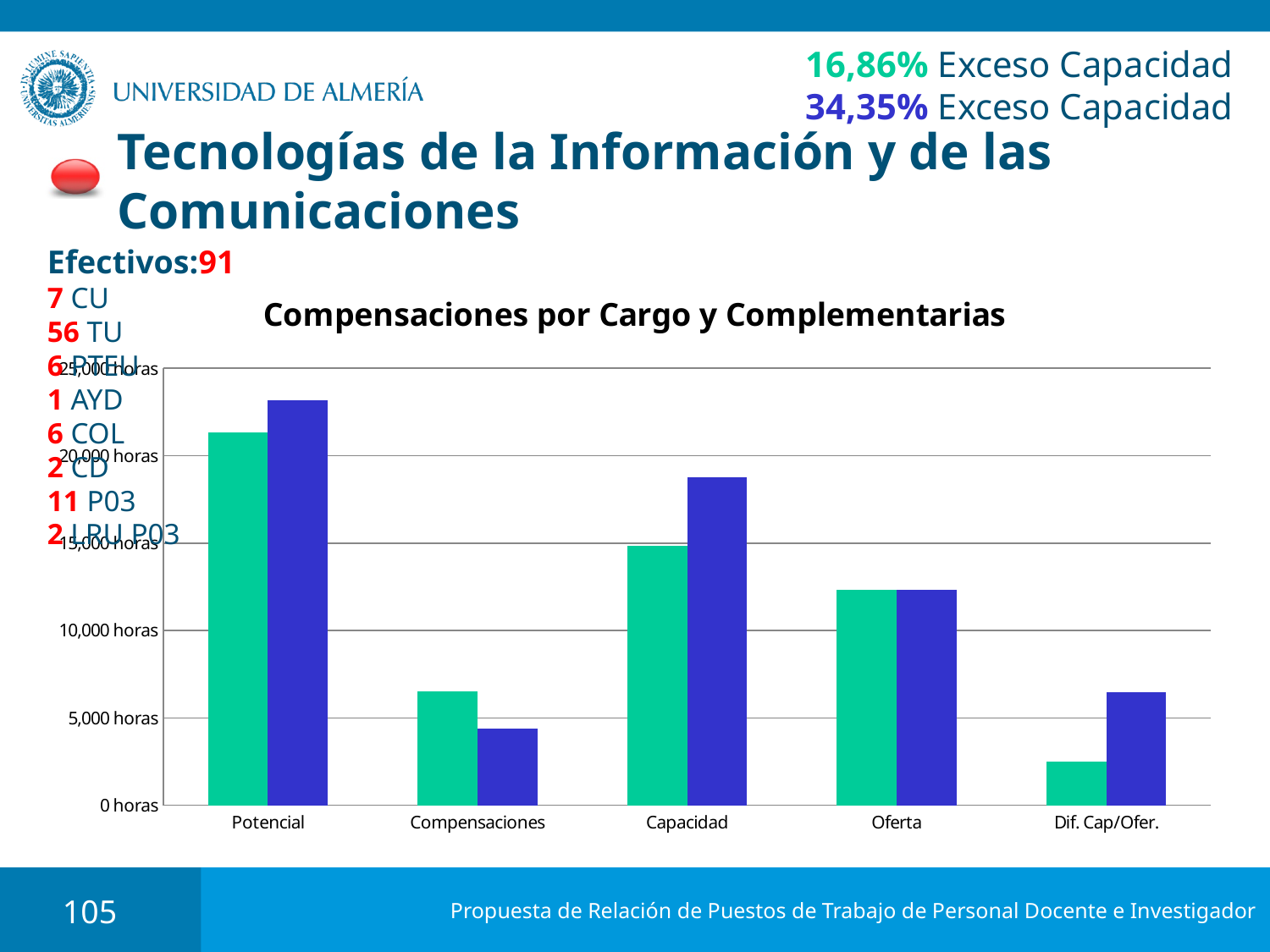
Which category has the shortest green bar? Dif. Cap/Ofer. What is the title of the chart? Compensaciones por Cargo y Complementarias Is the green bar for Potencial greater or less than 20,000 horas? greater For Capacidad, which bar is taller, the green one or the blue one? the blue one How many categories are shown on the x axis of the chart? 5 What kind of chart is shown on the slide? bar chart Is the green bar for Dif. Cap/Ofer. greater or less than 5,000 horas? less Is the blue bar for Capacidad greater or less than 15,000 horas? greater Which category has the tallest blue bar? Potencial Which category has the tallest green bar? Potencial How many bars are plotted for each category in the chart? 2